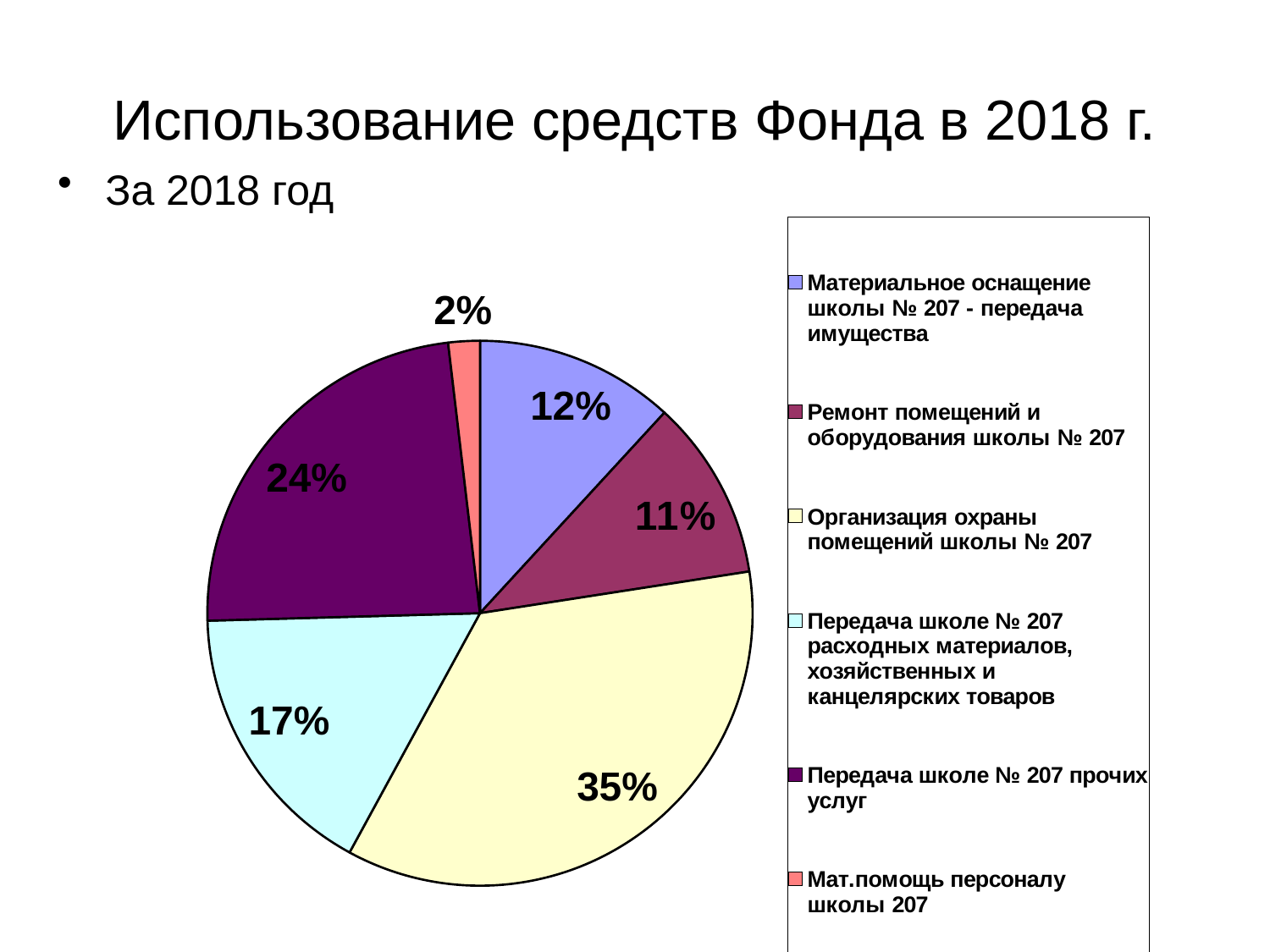
What share of the pie is "Мат.помощь персоналу школы 207"? 2% What share of the pie is "Материальное оснащение школы № 207 - передача имущества"? 12% What share of the pie is "Передача школе № 207 прочих услуг"? 24% What kind of chart is shown on the slide? Pie chart Which is larger: the share for "Передача школе № 207 расходных материалов, хозяйственных и канцелярских товаров" or the share for "Ремонт помещений и оборудования школы № 207"? Передача школе № 207 расходных материалов, хозяйственных и канцелярских товаров Which category has the smallest share of the pie? Мат.помощь персоналу школы 207 How many slices does the pie chart have? 6 Which category has the largest share of the pie? Организация охраны помещений школы № 207 What is the title of the slide containing the pie chart? Использование средств Фонда в 2018 г. What is the difference between the share for "Организация охраны помещений школы № 207" and the share for "Передача школе № 207 прочих услуг"? 11% How many entries does the legend list? 6